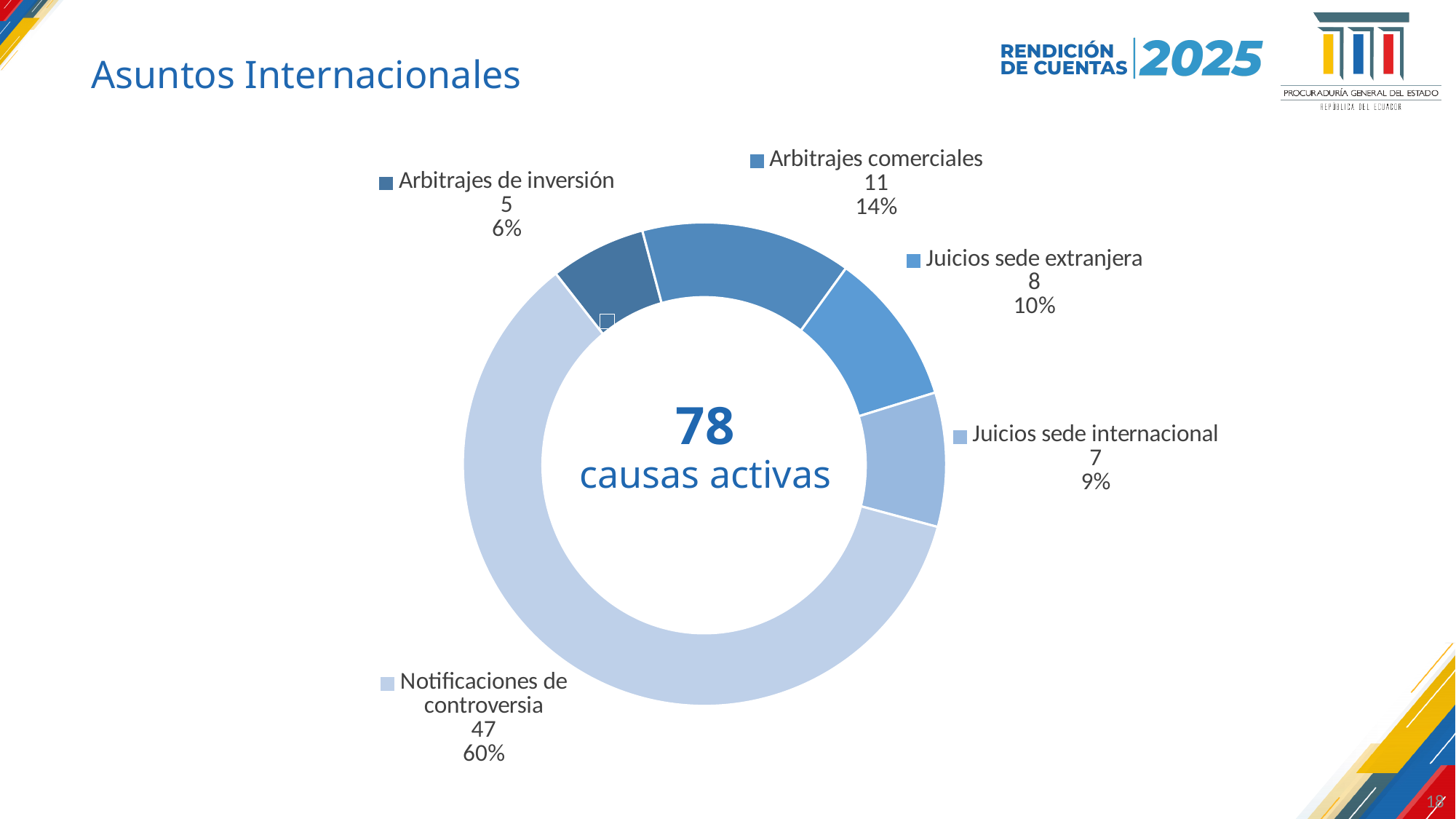
What percentage share does Arbitrajes de inversión have? 6% How many categories does the doughnut chart show? 5 What is the value for Arbitrajes comerciales? 11 What is the value for Notificaciones de controversia? 47 Which category has the smallest value? Arbitrajes de inversión What is the value for Juicios sede extranjera? 8 Which is larger, the value for Juicios sede extranjera or the value for Arbitrajes de inversión? Juicios sede extranjera What total number of active cases is shown in the centre of the doughnut chart? 78 What percentage share does Juicios sede internacional have? 9% Which category has the largest value? Notificaciones de controversia What is the difference between the values for Arbitrajes comerciales and Juicios sede internacional? 4 What kind of chart is shown on the slide? Doughnut chart